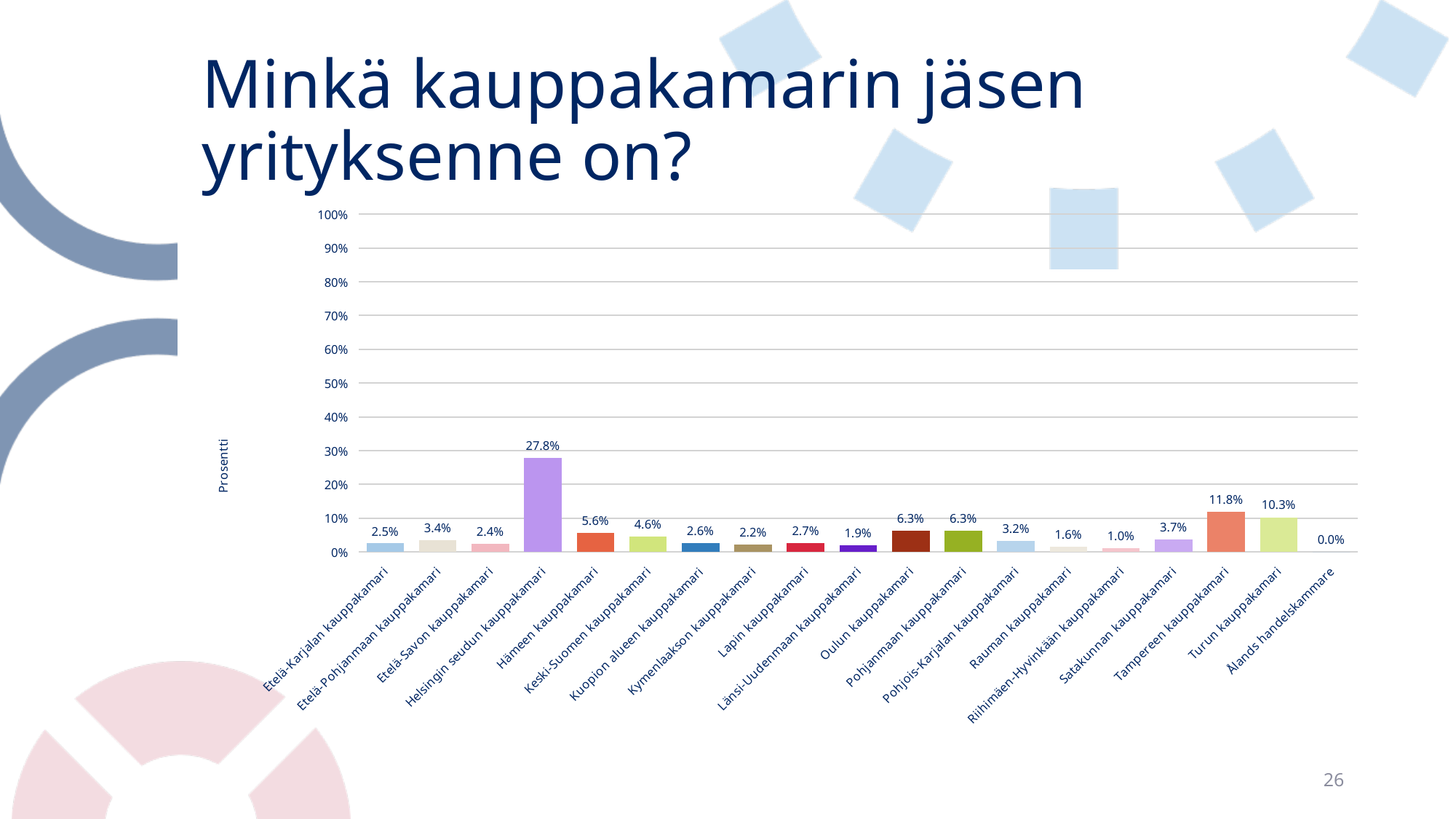
What is the value for Riihimäen-Hyvinkään kauppakamari? 1.0% Is the value for Helsingin seudun kauppakamari greater or less than 20%? greater Which category has the lowest value? Ålands handelskammare What is the label of the y axis? Prosentti Which is larger, the value for Hämeen kauppakamari or the value for Keski-Suomen kauppakamari? Hämeen kauppakamari Which category has the highest value? Helsingin seudun kauppakamari What kind of chart is shown on the slide? bar chart What is the value for Ålands handelskammare? 0.0% What is the value for Helsingin seudun kauppakamari? 27.8% How many categories are shown on the x axis? 19 What is the difference between the values for Tampereen kauppakamari and Turun kauppakamari? 1.5% What is the value for Tampereen kauppakamari? 11.8%